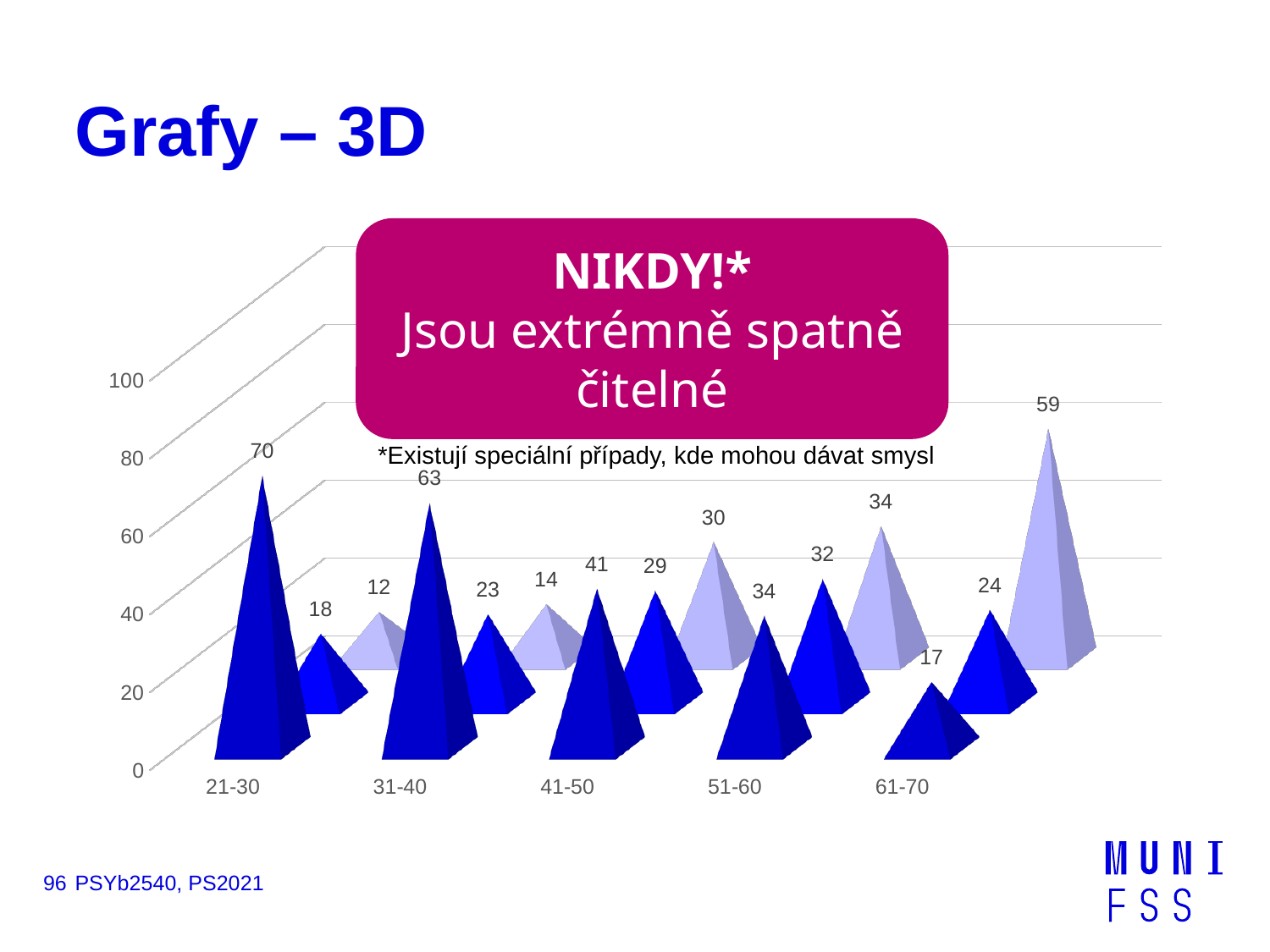
Which age category contains the highest labelled value in the chart? 21-30 How many age categories are shown on the x axis? 5 Do the values of the dark blue (front) series rise or fall from 21-30 to 61-70? fall What is the title of the chart slide? Grafy – 3D What is the value of the dark blue (front) pyramid for the 21-30 category? 70 What is the difference between the dark blue (front) values for 21-30 and 31-40? 7 What is the lowest data label shown in the chart? 12 What is the value of the light blue (back) pyramid for the 61-70 category? 59 In the 61-70 category, which is larger: the light blue (back) pyramid or the dark blue (front) pyramid? light blue (back) pyramid What is the value of the dark blue (front) pyramid for the 61-70 category? 17 What is the highest data label shown in the chart? 70 What kind of chart is shown on the slide? bar chart (3D pyramid bars)